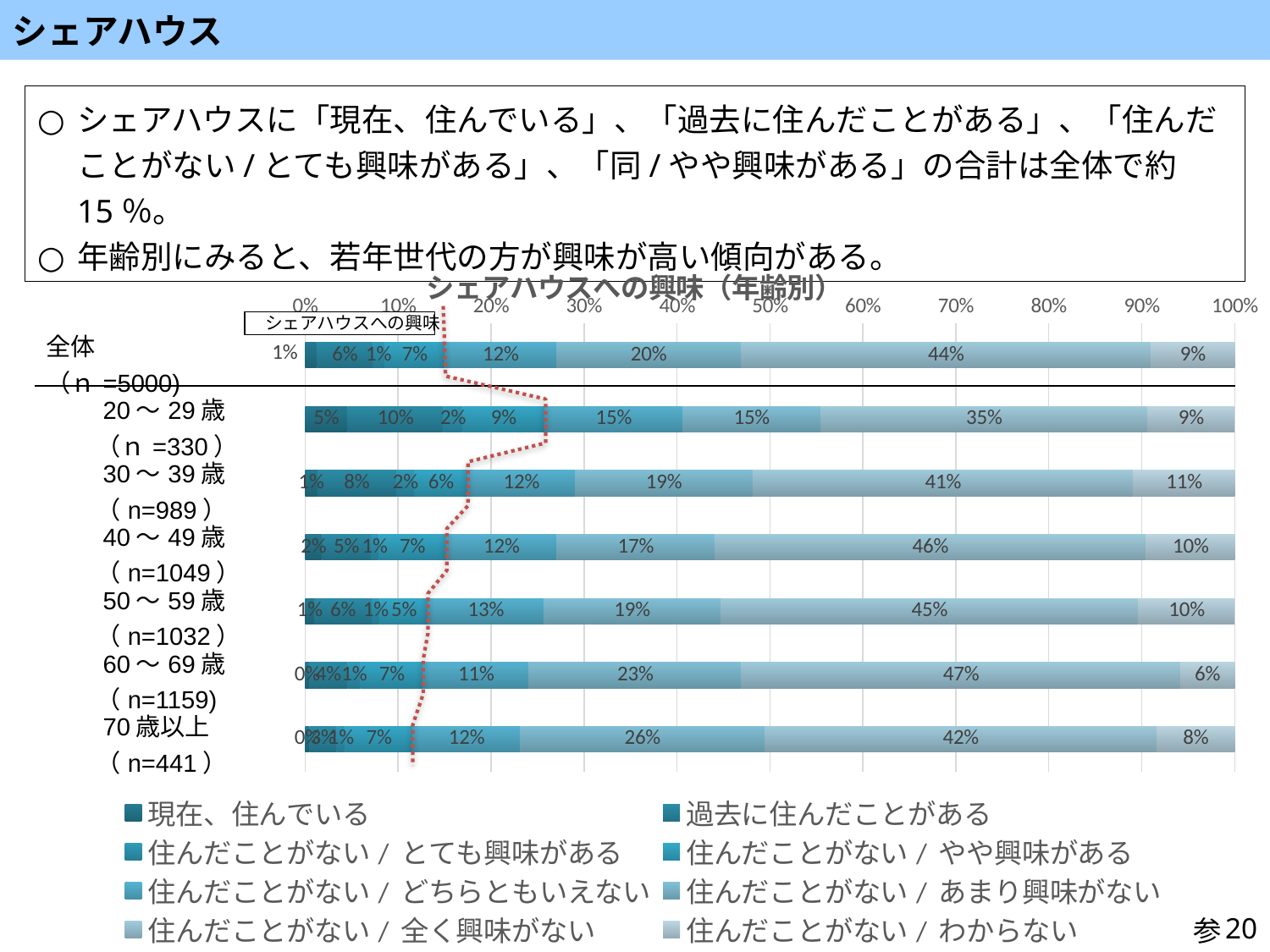
What is the value of 「住んだことがない / あまり興味がない」 for 全体? 20% What is the value of 「住んだことがない / 全く興味がない」 for 60～69歳? 47% What kind of chart is shown on the slide? Stacked bar chart How many age-group categories (including 全体) are plotted in the chart? 7 How many series does the legend list? 8 Which category has the highest value for 「住んだことがない / あまり興味がない」? 70歳以上 What is the title of the chart? シェアハウスへの興味（年齢別） What is the value of 「住んだことがない / どちらともいえない」 for 50～59歳? 13% What is the value of 「現在、住んでいる」 for 20～29歳? 5% Which category has the lowest value for 「住んだことがない / あまり興味がない」? 20～29歳 What is the difference between the 「住んだことがない / あまり興味がない」 values for 全体 and 20～29歳? 5 percentage points Which is larger: the 「住んだことがない / どちらともいえない」 value for 20～29歳 or for 60～69歳? 20～29歳